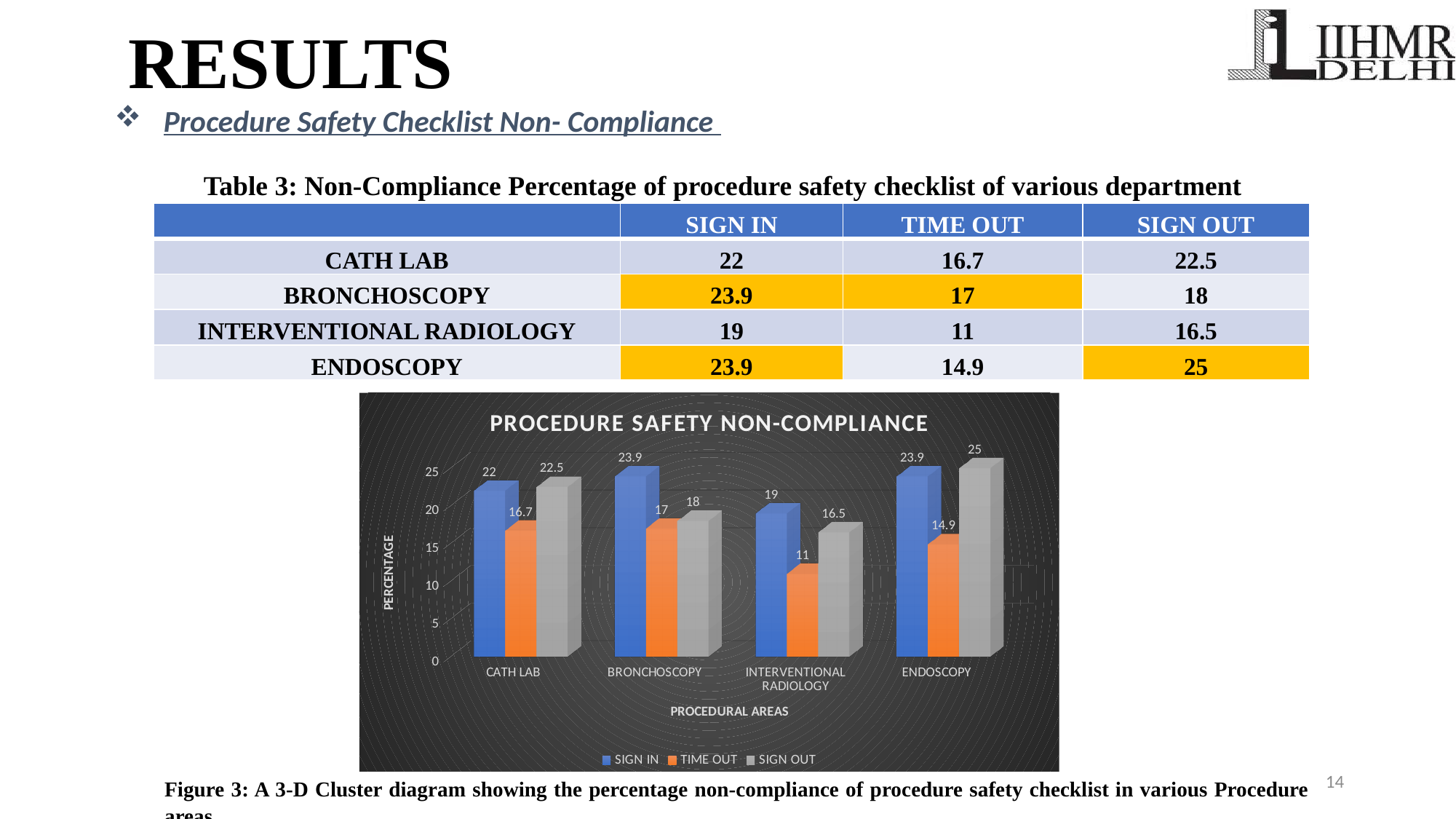
How many procedural areas are shown on the x axis of the chart? 4 What is the SIGN OUT value for ENDOSCOPY in the chart? 25 What is the TIME OUT value for INTERVENTIONAL RADIOLOGY? 11 What is the label of the y axis of the chart? PERCENTAGE Which is larger for BRONCHOSCOPY, the SIGN IN value or the SIGN OUT value? SIGN IN Which procedural area has the highest SIGN OUT value? ENDOSCOPY Which procedural area has the lowest TIME OUT value? INTERVENTIONAL RADIOLOGY What kind of chart is shown on the slide? Bar chart What is the title of the chart? PROCEDURE SAFETY NON-COMPLIANCE What is the SIGN IN value for CATH LAB? 22 What is the difference between the SIGN OUT values for ENDOSCOPY and INTERVENTIONAL RADIOLOGY? 8.5 How many series does the chart legend list? 3